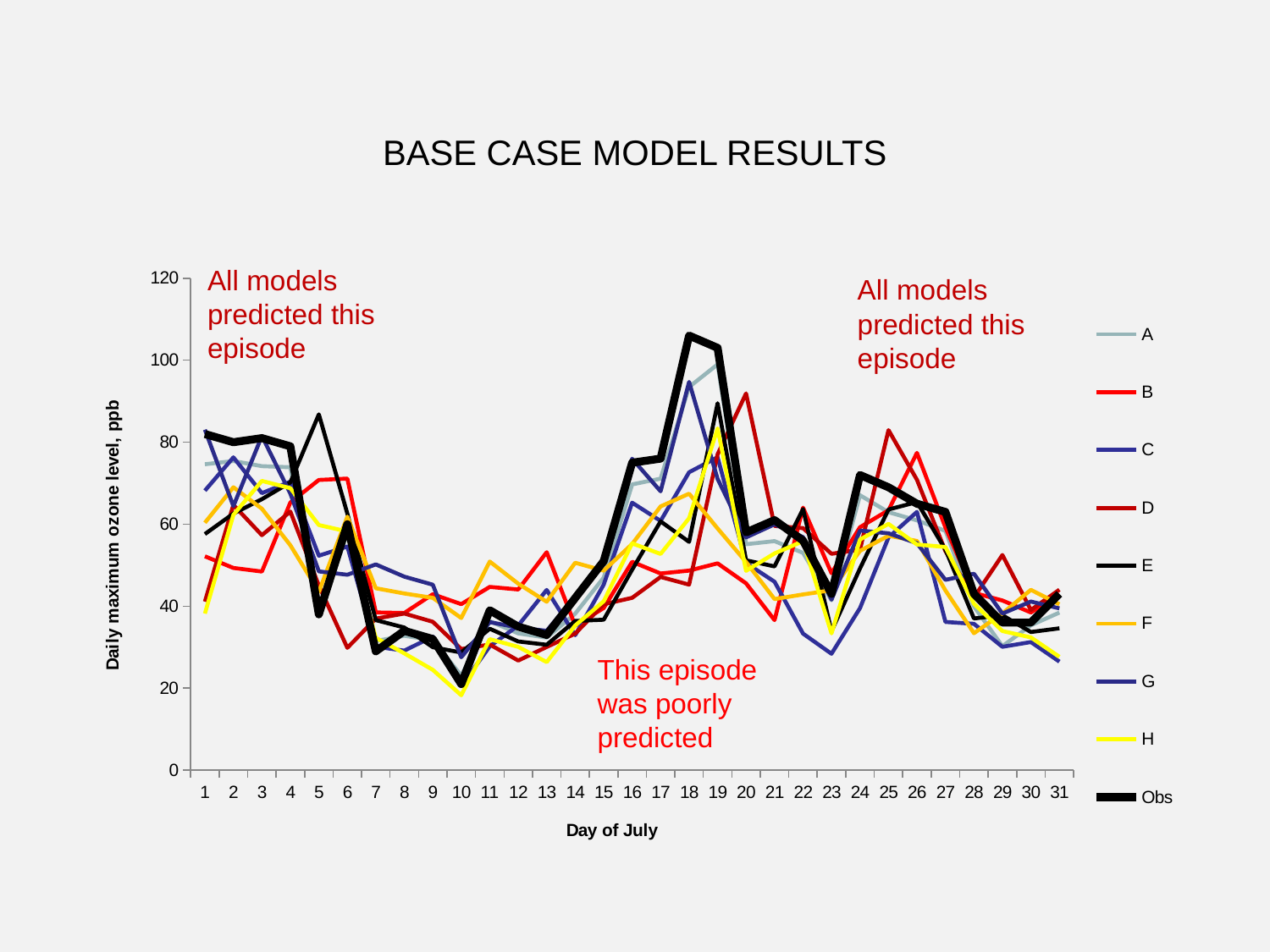
How many series does the legend list? 9 Is the Obs value on day 10 greater or less than 40? less What kind of chart is shown on the slide? line chart What is the title of the chart? BASE CASE MODEL RESULTS Is the value for series D on day 20 greater or less than 80? greater On which day of July does the Obs series reach its highest value? 18 On which day of July does the Obs series reach its lowest value? 10 Does the Obs series rise or fall from day 18 to day 23? fall Is the Obs value on day 18 greater or less than 100? greater What is the label of the y axis? Daily maximum ozone level, ppb How many days are plotted along the x axis? 31